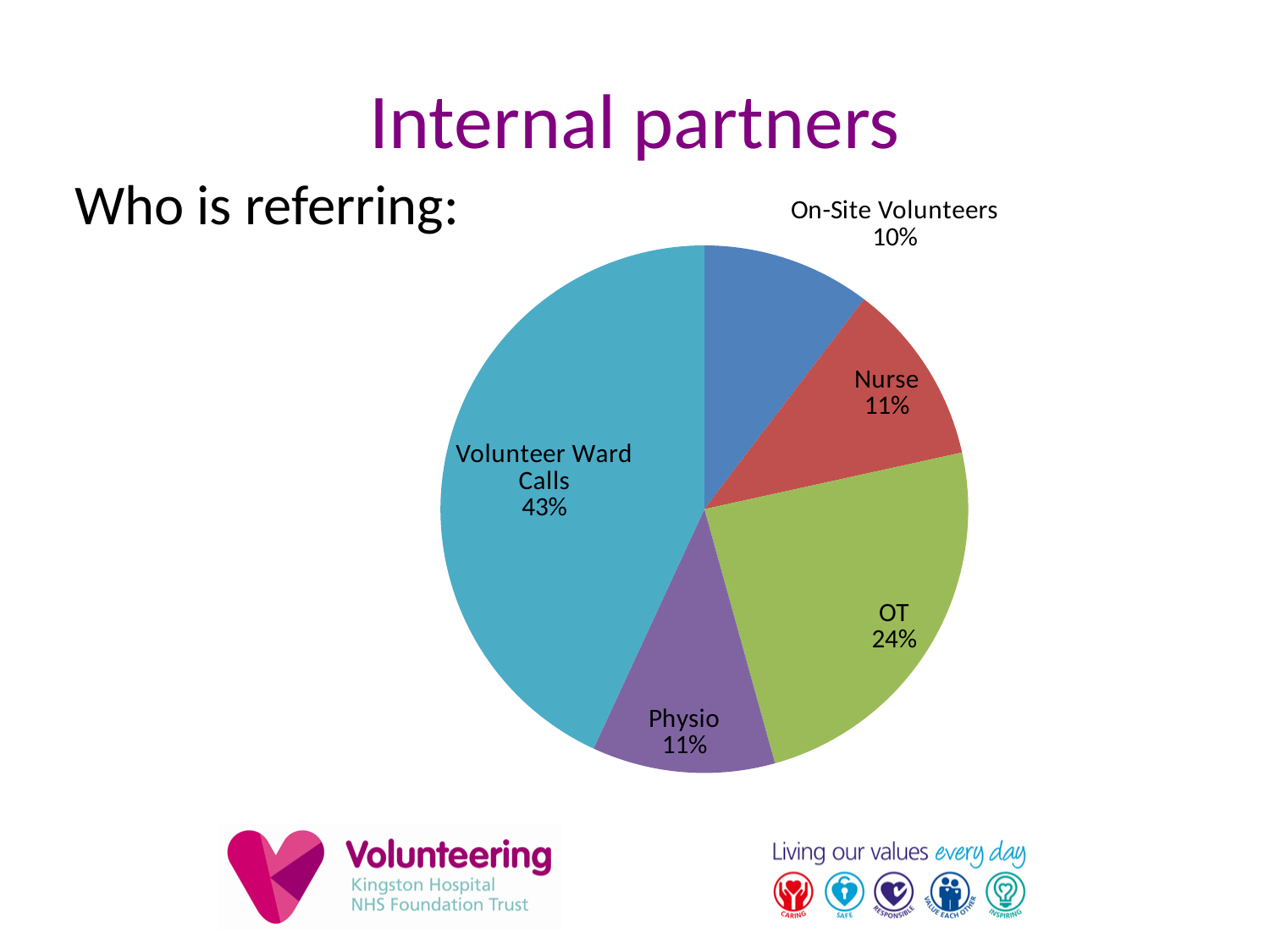
Which category has the smallest share of the pie? On-Site Volunteers Which is larger, the share for OT or the share for Physio? OT How many categories are shown in the pie chart? 5 What share of referrals comes from Nurse? 11% Which category has the largest share of the pie? Volunteer Ward Calls What is the combined share of Nurse and Physio? 22% What share of referrals comes from OT? 24% What share of referrals comes from On-Site Volunteers? 10% What is the difference in percentage points between Volunteer Ward Calls and OT? 19 What share of referrals comes from Volunteer Ward Calls? 43% What kind of chart is shown on the slide? pie chart What colour is the Volunteer Ward Calls slice? teal/light blue